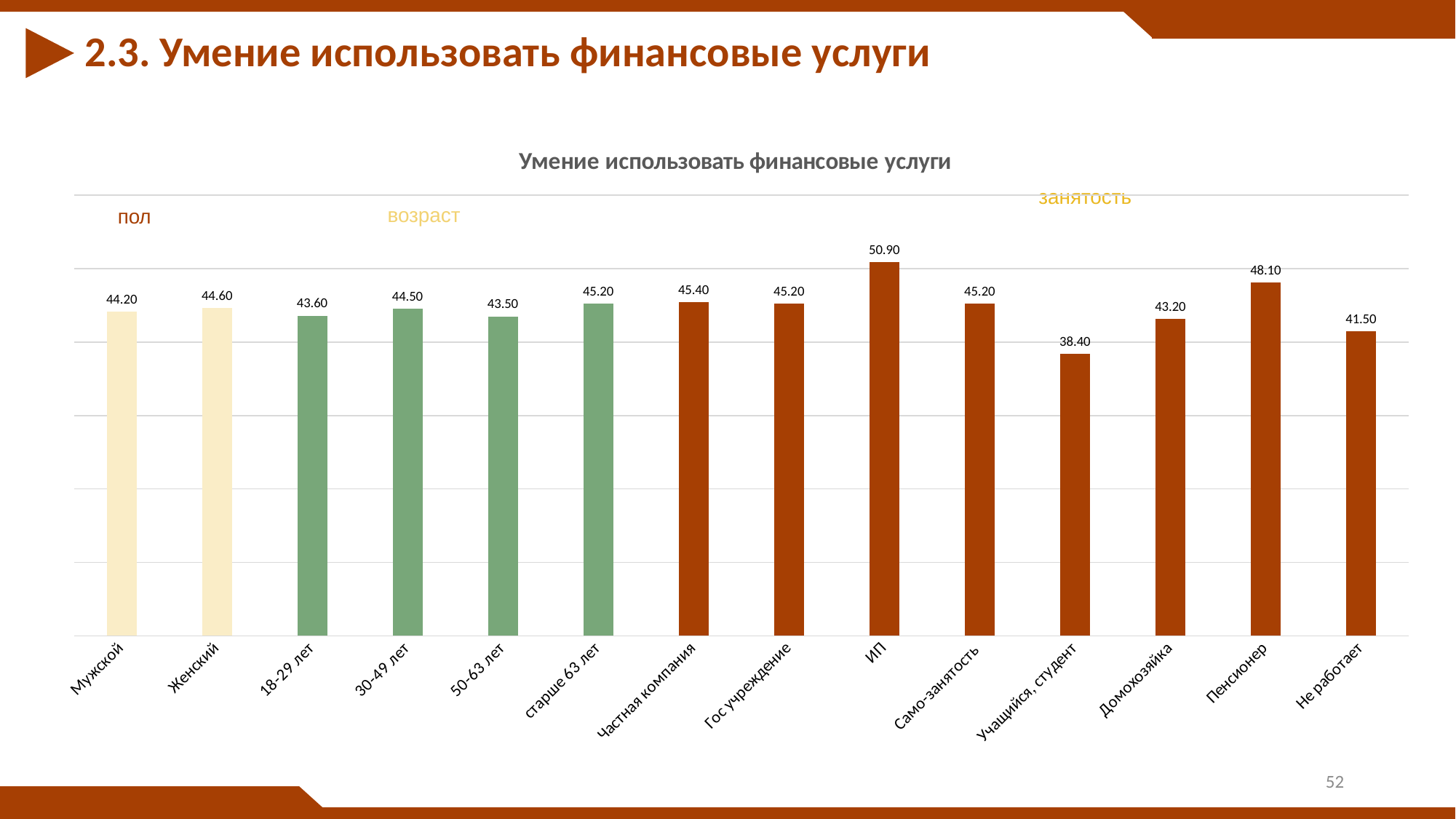
What is the value for Пенсионер? 48.10 Which category has the highest value? ИП What is the difference between the values for Пенсионер and Не работает? 6.60 What is the value for Учащийся, студент? 38.40 What kind of chart is shown? bar chart What is the value for Женский? 44.60 What is the value for ИП? 50.90 What is the title of the chart? Умение использовать финансовые услуги How many categories are shown on the x axis? 14 Which category has the lowest value? Учащийся, студент What is the difference between the values for ИП and Учащийся, студент? 12.50 Which is larger, the value for Домохозяйка or the value for Не работает? Домохозяйка